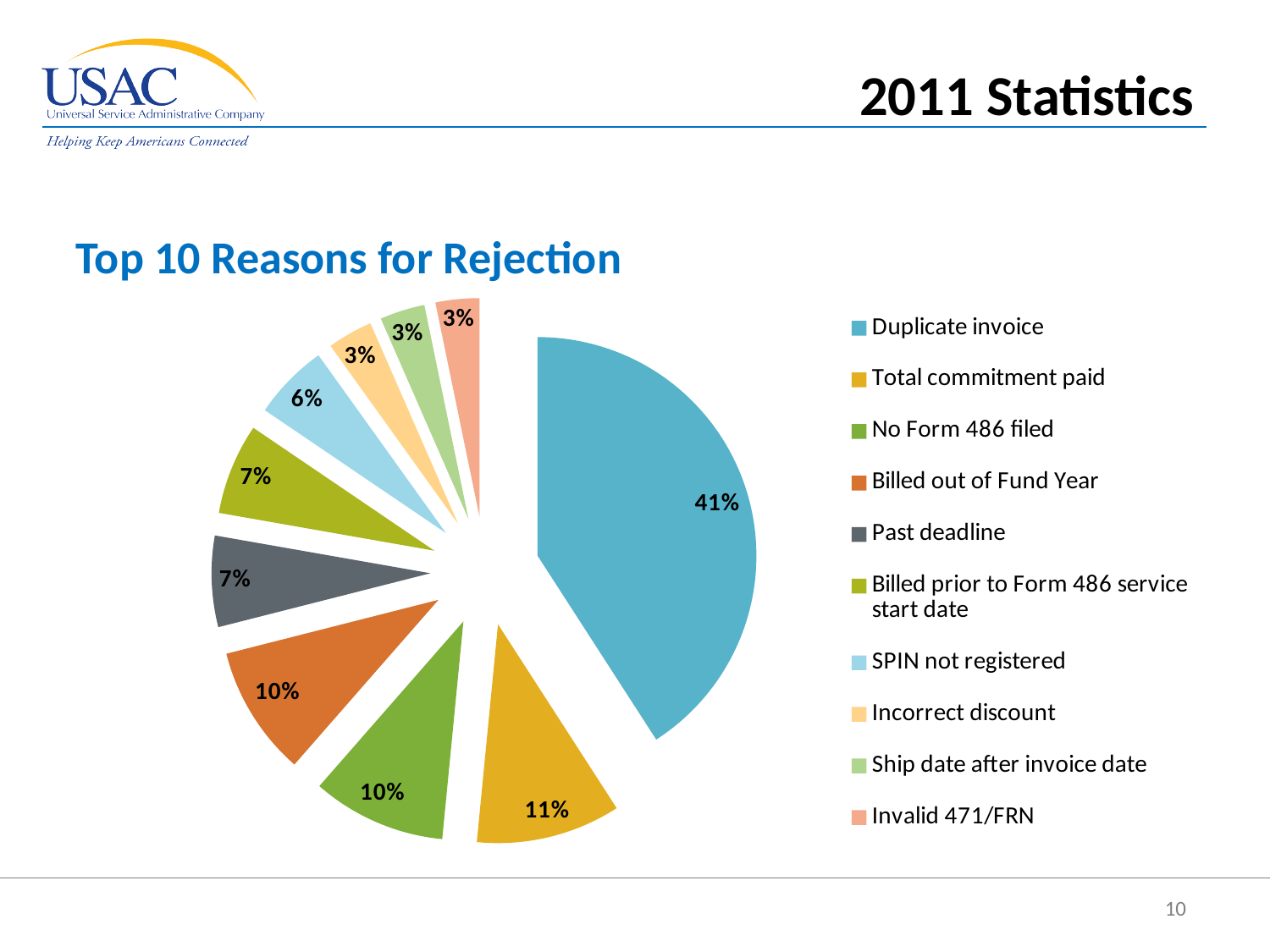
What percentage is shown for Total commitment paid? 11% What percentage is shown for Past deadline? 7% What is the title of the chart? Top 10 Reasons for Rejection Which reason for rejection has the largest share of the pie? Duplicate invoice What is the difference in percentage points between Duplicate invoice and Total commitment paid? 30 What kind of chart is shown on the slide? pie chart What percentage is shown for SPIN not registered? 6% What percentage is shown for Invalid 471/FRN? 3% How many categories does the legend list? 10 What share of rejections is attributed to Duplicate invoice? 41% What is the combined share of No Form 486 filed and Billed out of Fund Year? 20% Which is larger, the share for Billed out of Fund Year or the share for SPIN not registered? Billed out of Fund Year